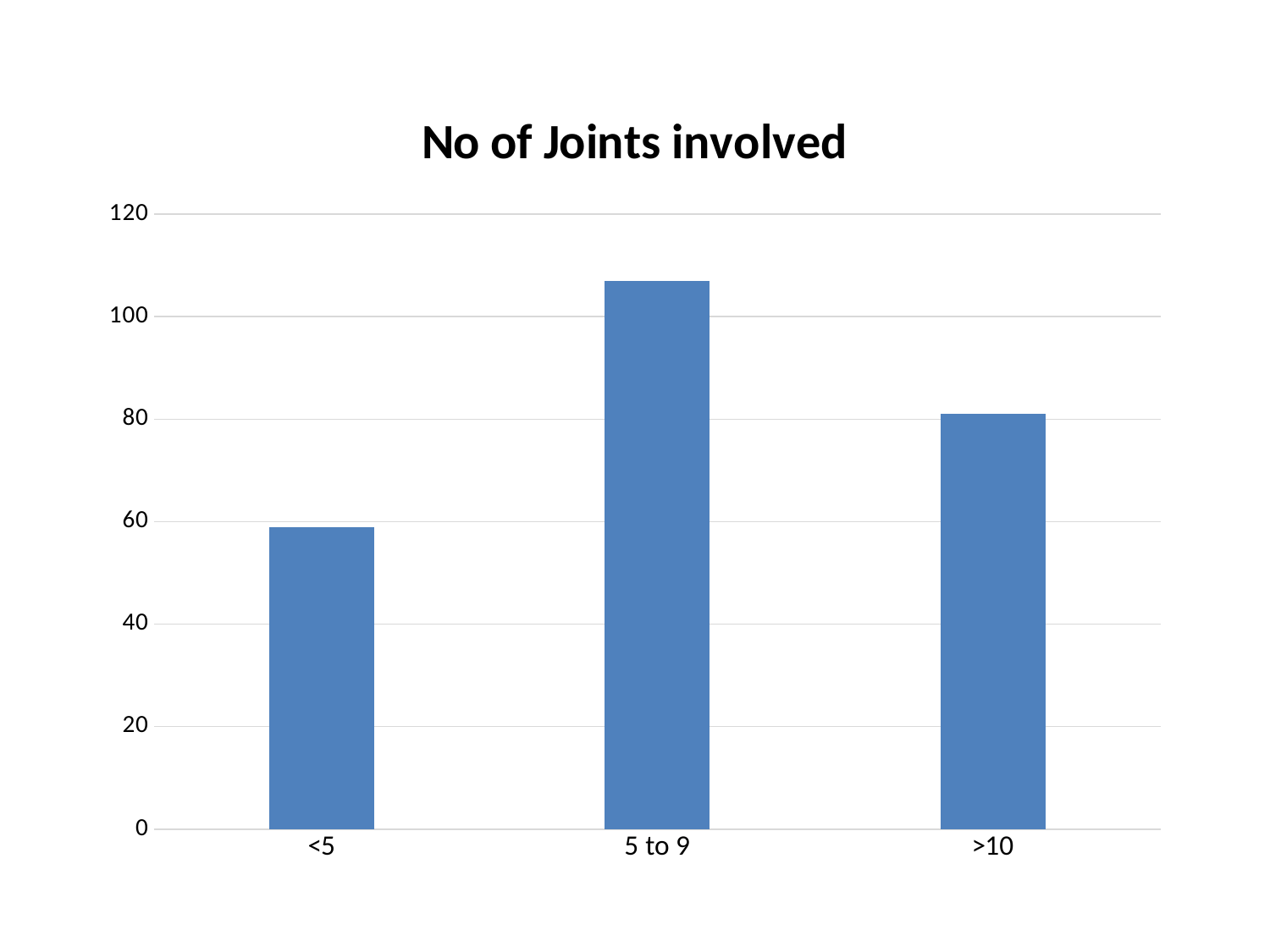
Which category has the lowest value? <5 Which is larger, the value for >10 or the value for <5? >10 How many categories are shown on the x axis? 3 What is the maximum value shown on the y axis? 120 Is the value for >10 greater or less than 60? greater What type of chart is shown on the slide? bar chart Which category has the highest value? 5 to 9 Is the value for >10 greater or less than 100? less Which is larger, the value for 5 to 9 or the value for >10? 5 to 9 What is the title of the chart? No of Joints involved Is the value for <5 greater or less than 40? greater